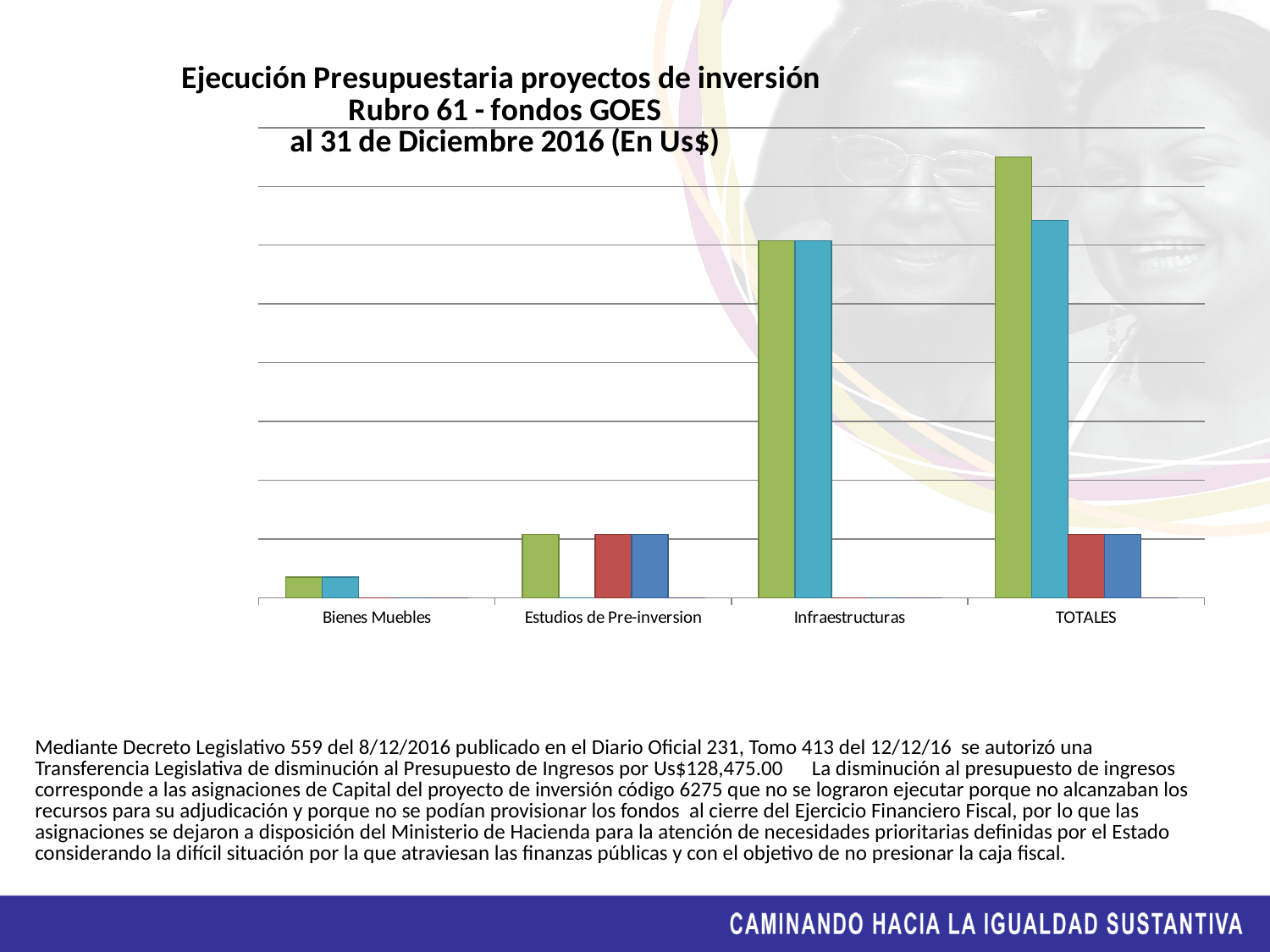
What is the first line of the chart title? Ejecución Presupuestaria proyectos de inversión Do the green bars rise or fall moving from left to right along the x axis? rise What kind of chart is shown on the slide? bar chart Which category has the tallest light blue bar? TOTALES Which category has the shortest green bar? Bienes Muebles Is the light blue bar for TOTALES taller or shorter than the light blue bar for Infraestructuras? taller Is the green bar for Bienes Muebles taller or shorter than the green bar for Estudios de Pre-inversion? shorter How many categories are shown on the x axis of the chart? 4 Which category has the tallest green bar? TOTALES Is the green bar for Infraestructuras taller or shorter than the green bar for Estudios de Pre-inversion? taller According to the chart title, in what currency are the values expressed? Us$